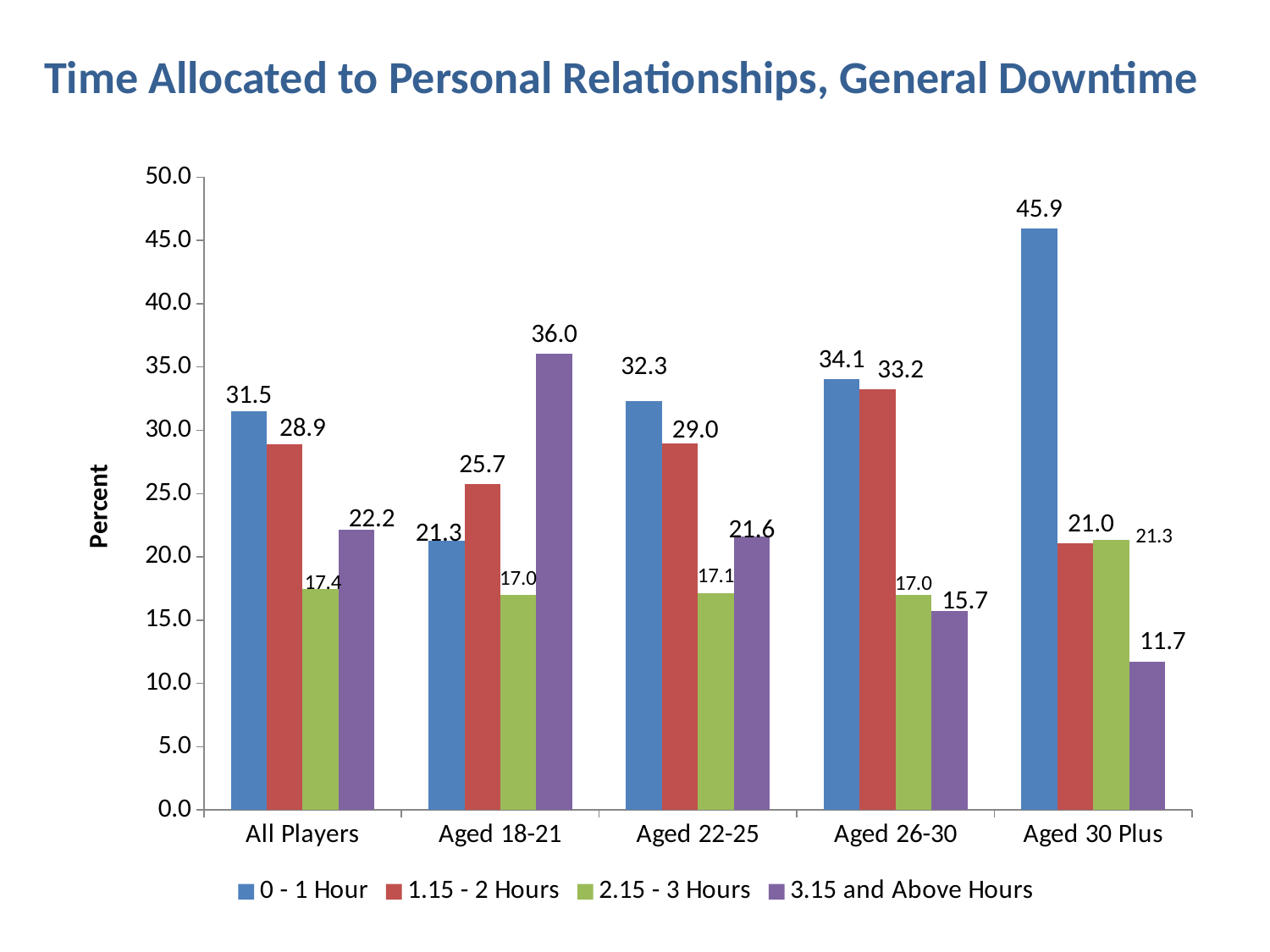
What is the difference between the 0 - 1 Hour and 1.15 - 2 Hours values for Aged 30 Plus? 24.9 Which age group has the lowest value for 3.15 and Above Hours? Aged 30 Plus Which age group has the highest value for 0 - 1 Hour? Aged 30 Plus How many age group categories are shown on the x axis? 5 What is the label on the vertical axis? Percent For Aged 18-21, which is larger: 1.15 - 2 Hours or 3.15 and Above Hours? 3.15 and Above Hours Is the value for 0 - 1 Hour for Aged 26-30 greater or less than 30.0? greater What is the value for 3.15 and Above Hours for Aged 18-21? 36.0 What is the value for 0 - 1 Hour for Aged 30 Plus? 45.9 What kind of chart is shown on the slide? Bar chart How many series does the legend list? 4 What is the value for 2.15 - 3 Hours for All Players? 17.4